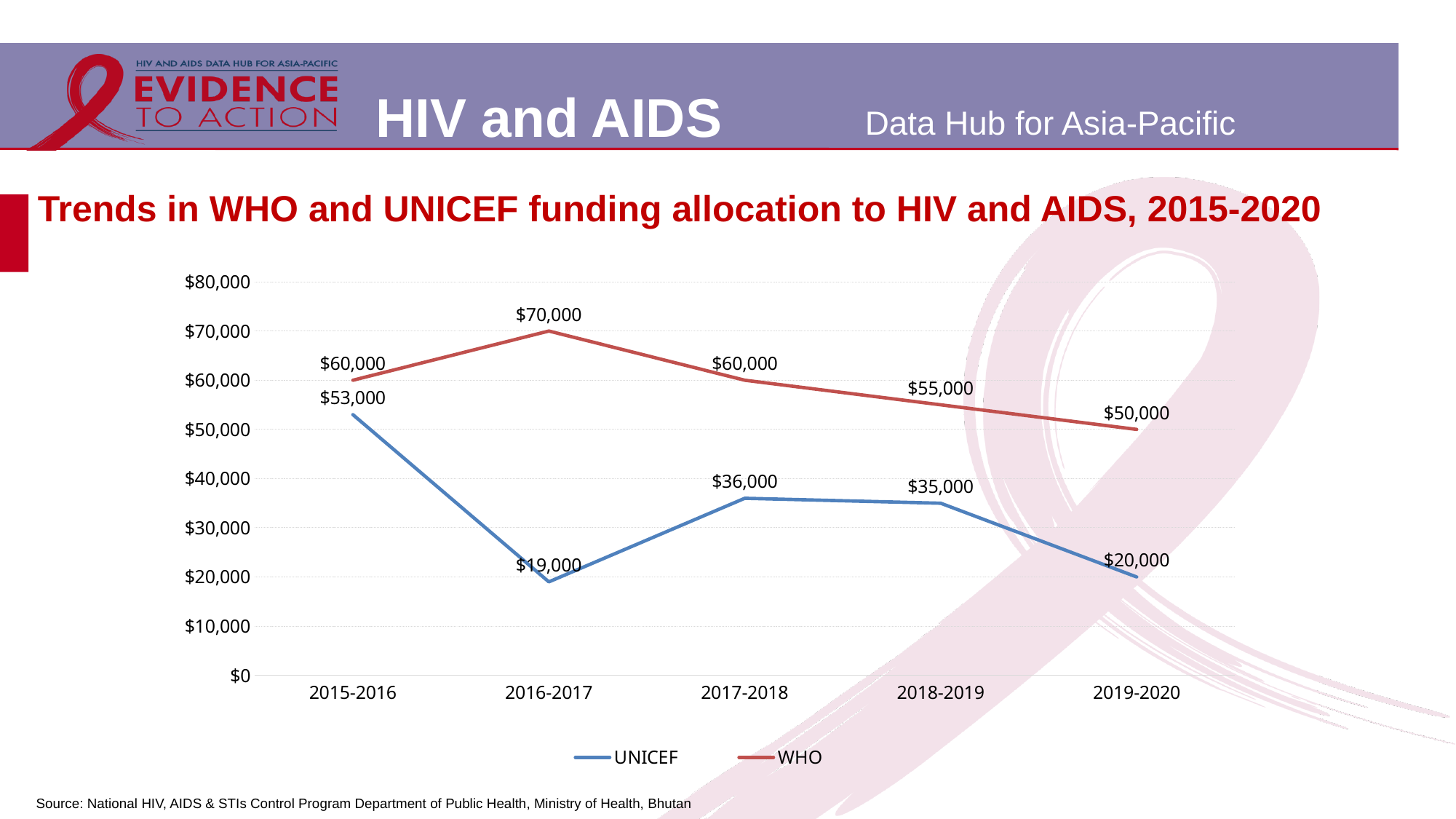
Which received more funding in 2015-2016, WHO or UNICEF? WHO In which period was the WHO funding allocation highest? 2016-2017 In which period was the UNICEF funding allocation lowest? 2016-2017 What kind of chart is shown on the slide? Line chart What was the UNICEF funding allocation in 2019-2020? $20,000 What was the UNICEF funding allocation in 2016-2017? $19,000 What was the WHO funding allocation in 2016-2017? $70,000 Which colour represents the WHO series in the chart? Red Does the WHO funding allocation rise or fall from 2016-2017 to 2019-2020? Fall How many series does the legend list? 2 How many periods are shown on the x axis? 5 What is the difference between WHO and UNICEF funding in 2016-2017? $51,000